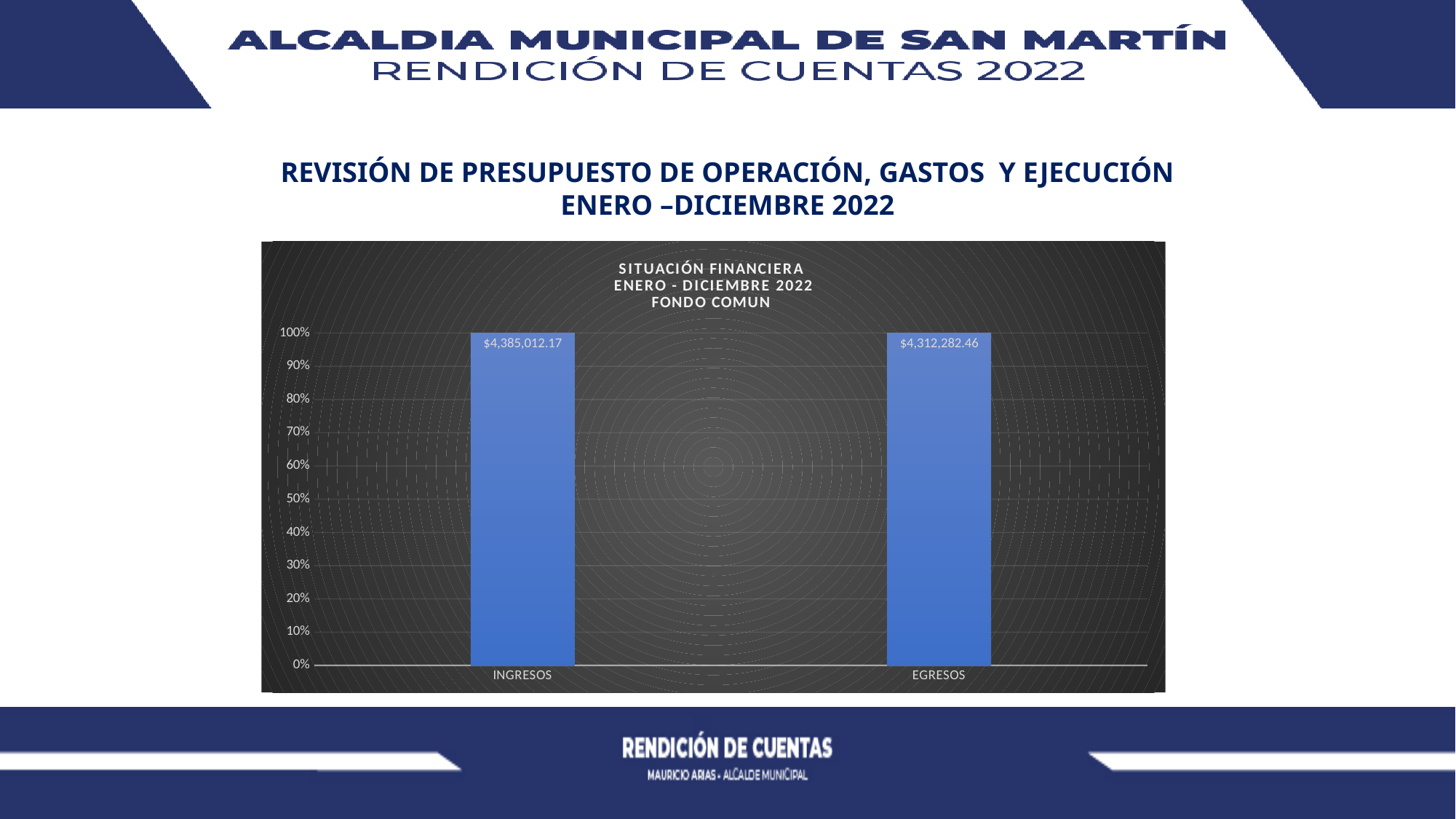
What is the highest percentage tick shown on the vertical axis? 100% What type of chart is shown on the slide? Bar chart Which category has the highest value according to the data labels? INGRESOS Is the bar for INGRESOS greater or less than 90% on the vertical axis? greater What is the value shown for EGRESOS? $4,312,282.46 What is the value shown for INGRESOS? $4,385,012.17 How many categories are plotted in the chart? 2 What is the difference between the INGRESOS and EGRESOS values shown on the data labels? $72,729.71 What is the title of the chart? SITUACIÓN FINANCIERA ENERO - DICIEMBRE 2022 FONDO COMUN Which is larger according to the data labels, INGRESOS or EGRESOS? INGRESOS Is the bar for EGRESOS greater or less than 50% on the vertical axis? greater